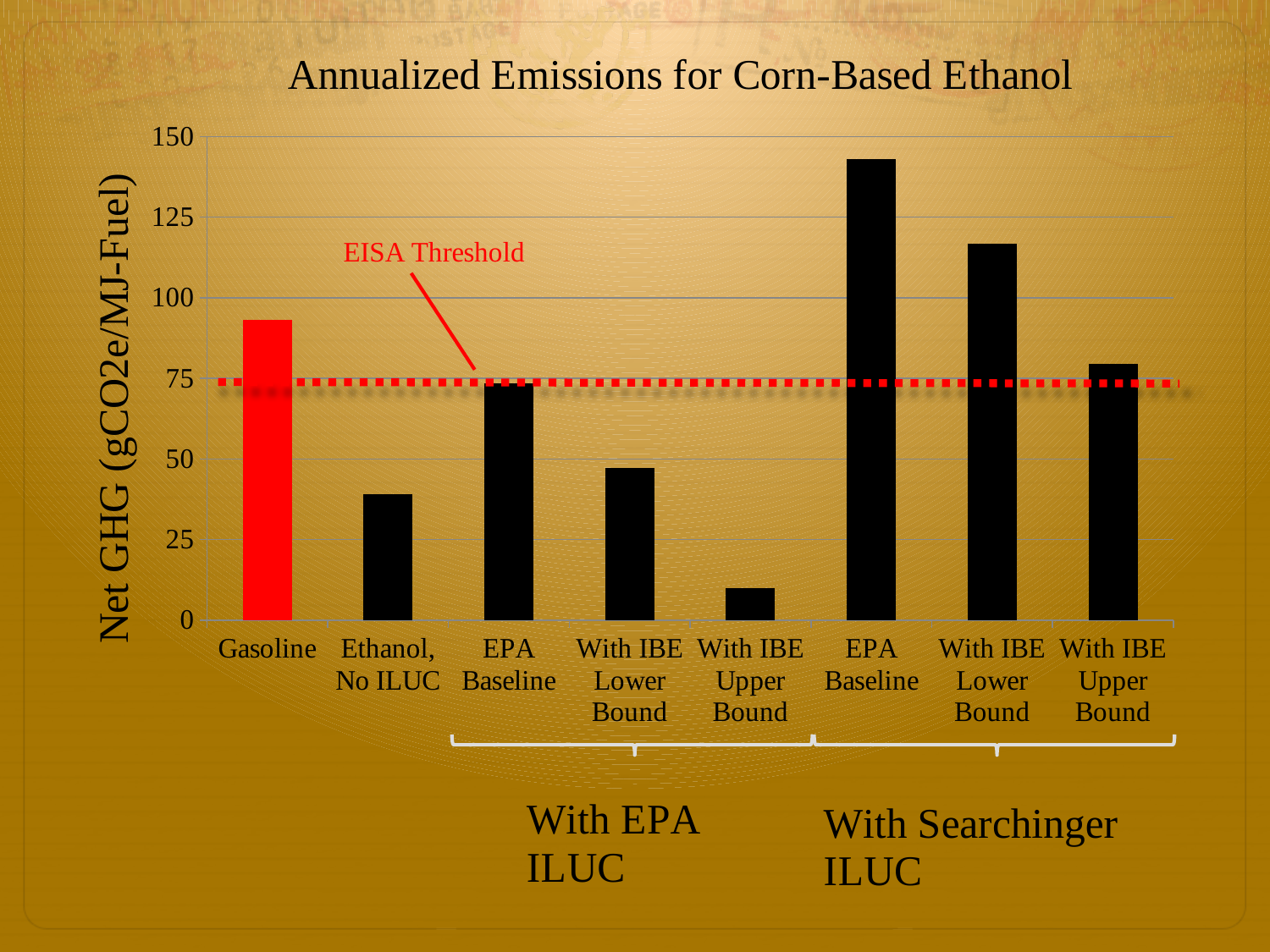
Is the value for Ethanol, No ILUC greater or less than 50? less Is the value for With IBE Upper Bound under With EPA ILUC greater or less than 25? less Which bar has the highest value in the chart? EPA Baseline (With Searchinger ILUC) What is the title of the chart? Annualized Emissions for Corn-Based Ethanol Is the value for Gasoline greater or less than 75? greater What kind of chart is shown on the slide? bar chart What is the label on the vertical axis of the chart? Net GHG (gCO2e/MJ-Fuel) Which bar has the lowest value in the chart? With IBE Upper Bound (With EPA ILUC) How many bars are plotted in the chart? 8 Which is larger, the value for Gasoline or the value for Ethanol, No ILUC? Gasoline